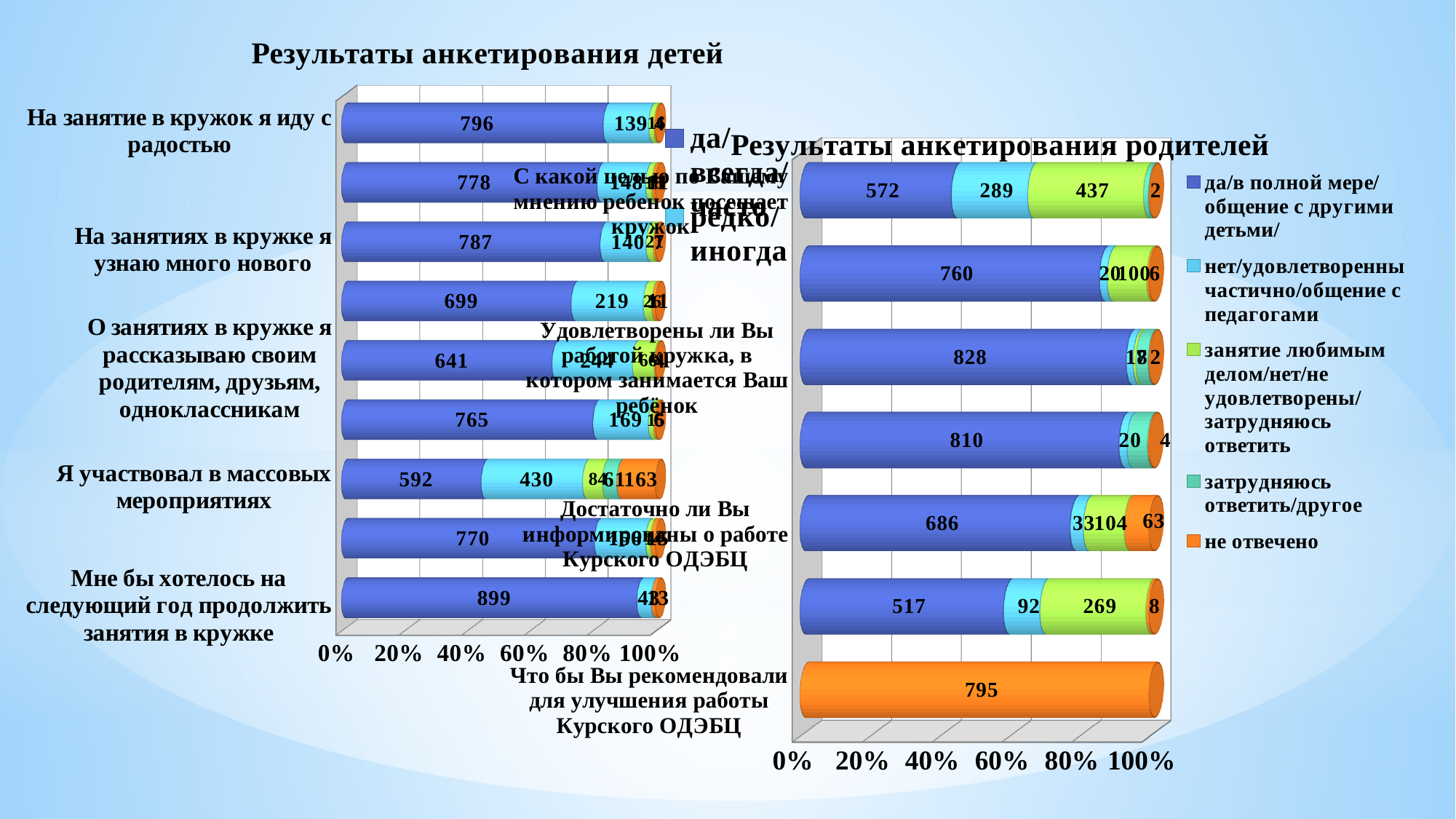
In the 'Результаты анкетирования детей' chart, what is the dark blue value for 'На занятие в кружок я иду с радостью'? 796 In the 'Результаты анкетирования родителей' chart, what is the value of the first (dark blue) series for 'С какой целью по Вашему мнению ребенок посещает кружок'? 572 In the 'Результаты анкетирования детей' chart, what is the dark blue value for 'Мне бы хотелось на следующий год продолжить занятия в кружке'? 899 What kind of chart is the 'Результаты анкетирования родителей' chart? bar chart In the 'Результаты анкетирования родителей' chart, what is the difference between the 'занятие любимым делом' value (437) and the 'нет/удовлетворенны частично' value (289) in the 'С какой целью...' bar? 148 What is the title of the chart on the left of the slide? Результаты анкетирования детей In the 'Результаты анкетирования детей' chart, which has the larger dark blue value: 'Мне бы хотелось на следующий год продолжить занятия в кружке' or 'На занятие в кружок я иду с радостью'? Мне бы хотелось на следующий год продолжить занятия в кружке In the 'Результаты анкетирования родителей' chart, what is the highest value shown for the dark blue series? 828 In the 'Результаты анкетирования детей' chart, what is the light blue value for 'Я участвовал в массовых мероприятиях'? 430 How many bars are plotted in the 'Результаты анкетирования родителей' chart? 7 In the 'Результаты анкетирования родителей' chart, what is the value of the 'не отвечено' series for 'Что бы Вы рекомендовали для улучшения работы Курского ОДЭБЦ'? 795 How many series does the legend of the 'Результаты анкетирования родителей' chart list? 5